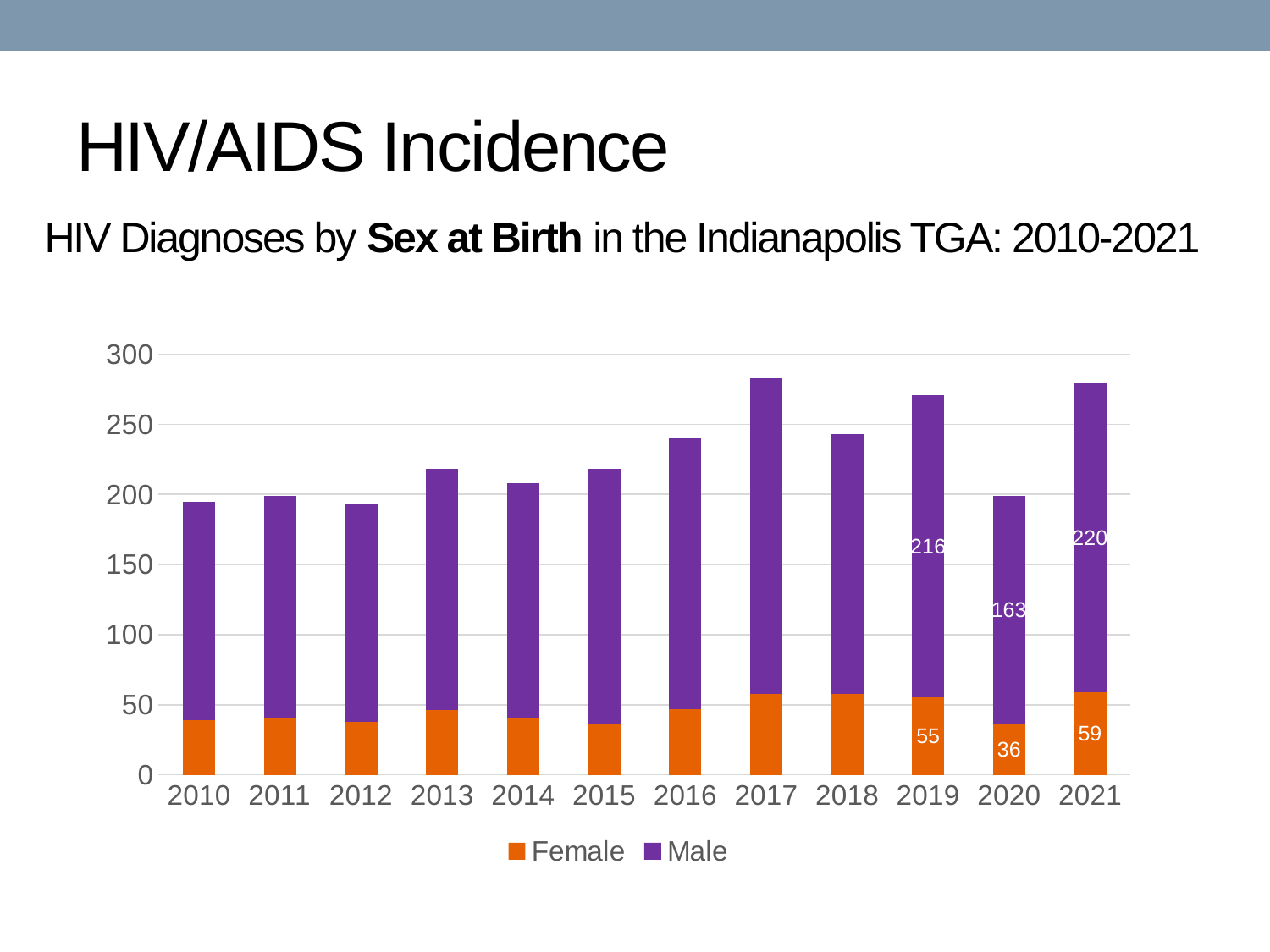
What is the Female value for 2019? 55 What is the total of the stacked bar for 2021? 279 What is the Male value for 2020? 163 Which is larger, the Female value for 2021 or the Female value for 2019? 2021 What is the Male value for 2021? 220 How many series does the legend list? 2 Is the total for 2017 greater or less than 250? greater What is the difference between the Male values for 2021 and 2020? 57 What is the Female value for 2020? 36 How many years are shown on the x axis? 12 What kind of chart is shown on the slide? Stacked bar chart What is the total of the stacked bar for 2020? 199